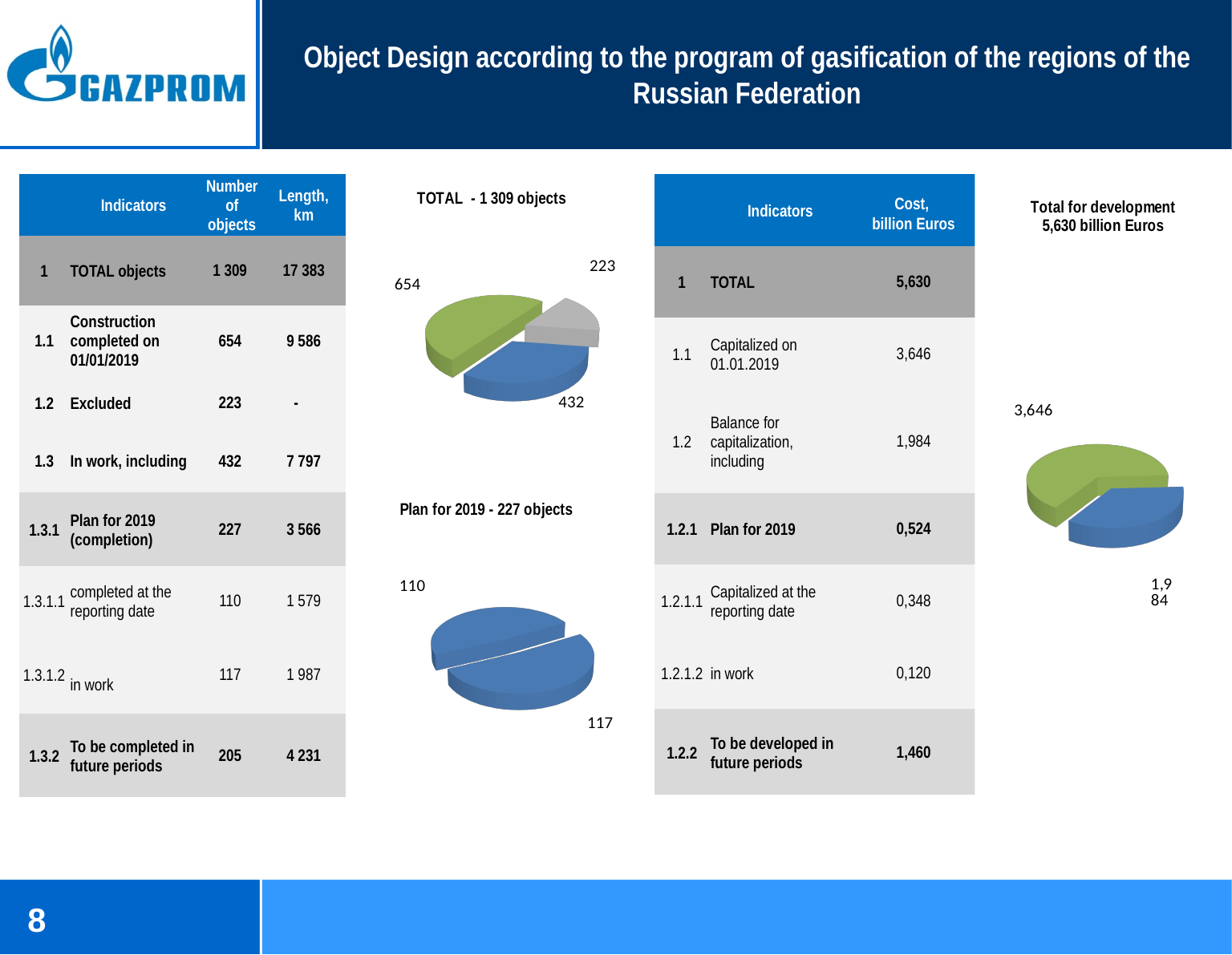
What kind of chart is the 'TOTAL - 1 309 objects' chart? pie chart In the 'Total for development 5,630 billion Euros' pie chart, what is the difference between the 3,646 slice and the 1,984 slice? 1,662 How many slices does the 'Plan for 2019 - 227 objects' pie chart have? 2 In the 'TOTAL - 1 309 objects' pie chart, what is the value of the smallest slice? 223 In the 'TOTAL - 1 309 objects' pie chart, what share of the total does the 223 slice represent? 17% In the 'TOTAL - 1 309 objects' pie chart, what colour is the largest slice? green In the 'TOTAL - 1 309 objects' pie chart, what is the value of the largest slice? 654 How many slices does the 'TOTAL - 1 309 objects' pie chart have? 3 In the 'Plan for 2019 - 227 objects' pie chart, what is the difference between the two slices? 7 In the 'TOTAL - 1 309 objects' pie chart, what is the difference between the 654 slice and the 432 slice? 222 In the 'Plan for 2019 - 227 objects' pie chart, which slice is larger, 110 or 117? 117 In the 'Total for development 5,630 billion Euros' pie chart, what is the value of the larger slice? 3,646